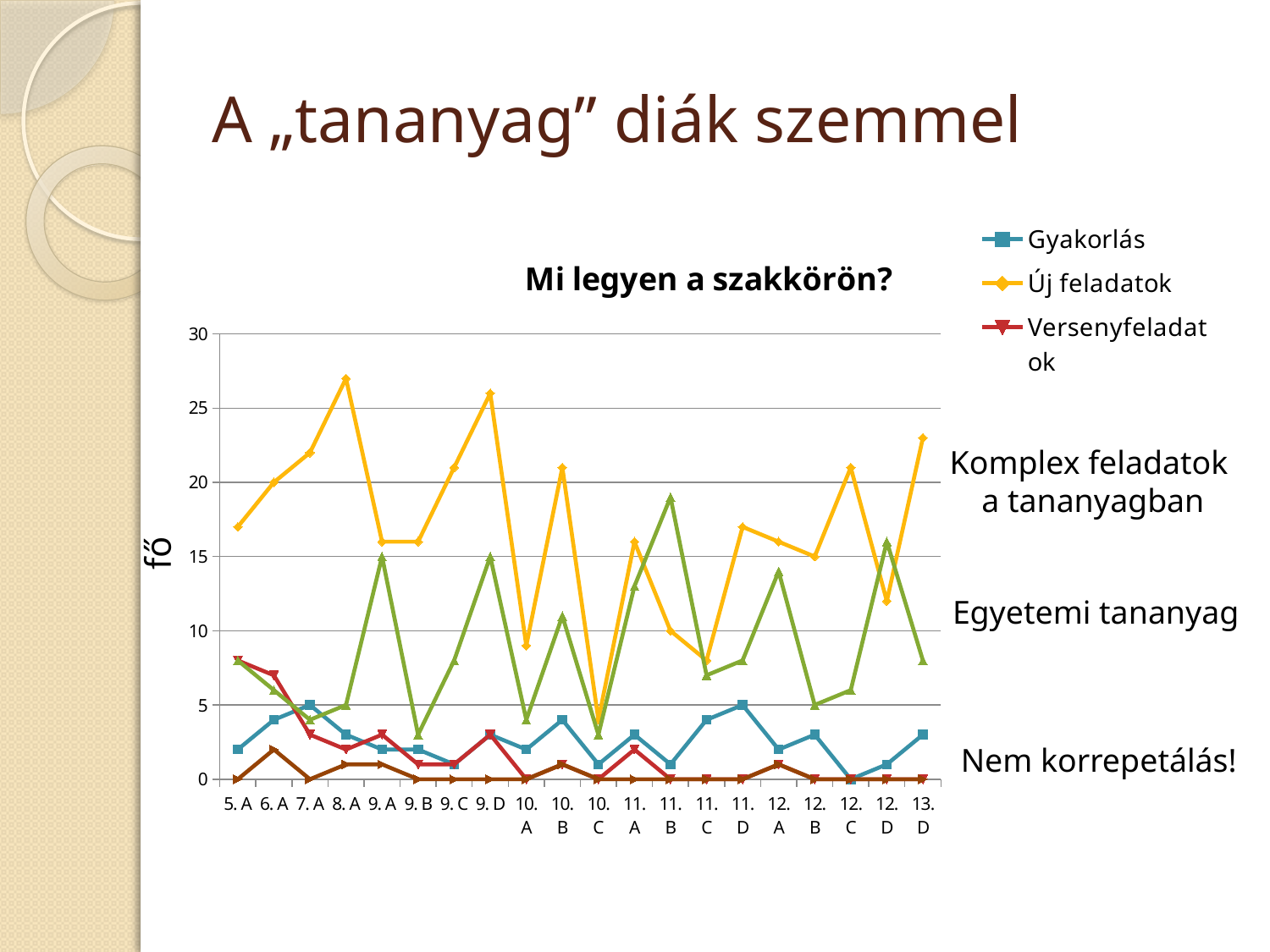
Is the value for Új feladatok at 8. A greater or less than 25? greater What kind of chart is shown on the slide? line chart At 6. A, which series has the larger value, Új feladatok or Gyakorlás? Új feladatok What is the value for Gyakorlás at 12. C? 0 How many categories are shown along the x axis? 20 What is the title of the chart? Mi legyen a szakkörön? Does the Új feladatok series rise or fall from 5. A to 8. A? rise Is the value for Új feladatok at 10. C greater or less than 10? less Is the value for Versenyfeladatok at 5. A greater or less than 5? greater What is the label on the vertical axis? fő How many series does the chart's legend list? 3 For which category is the Új feladatok series lowest? 10. C